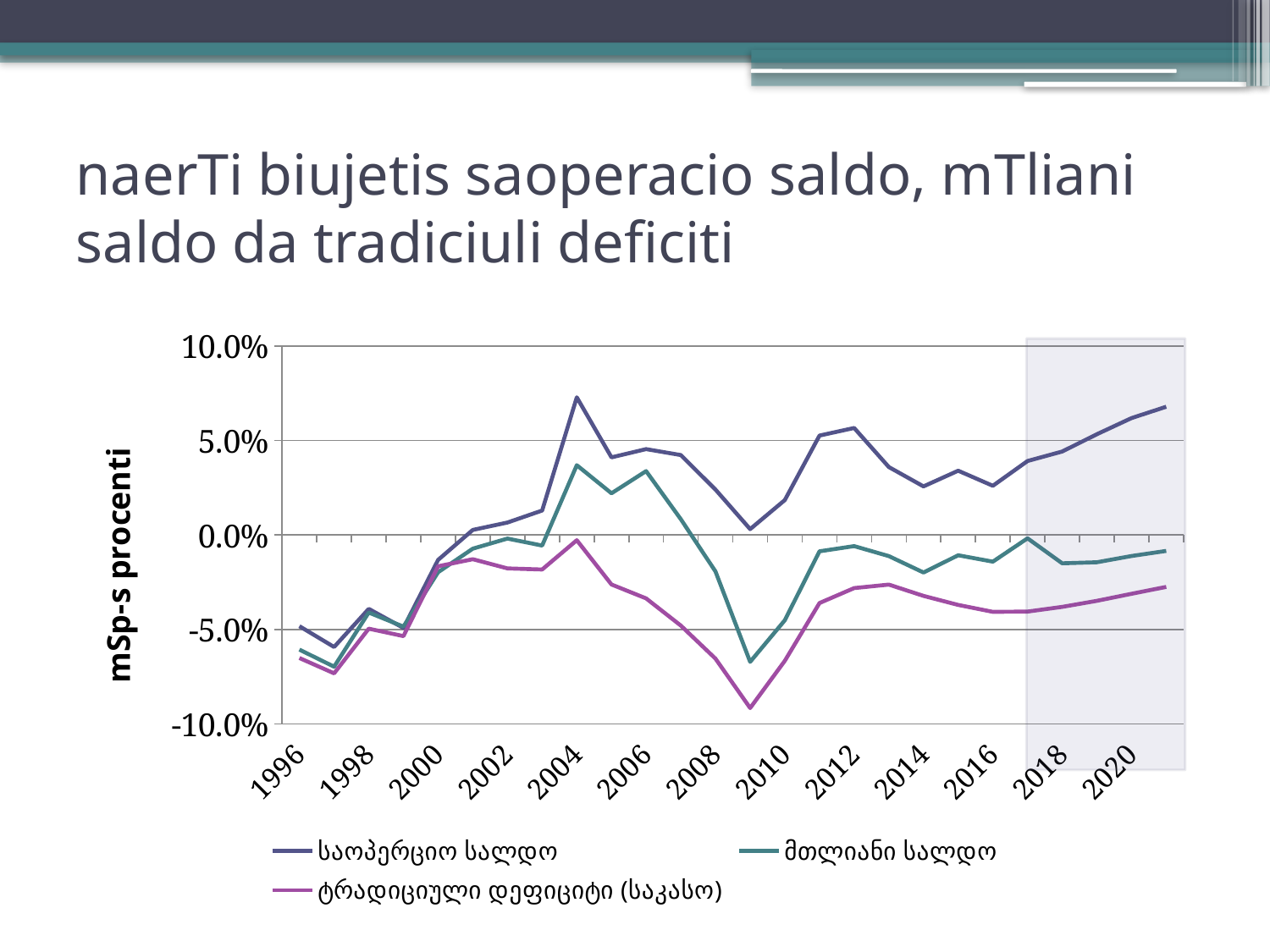
How many series does the chart's legend list? 3 In 2004, which series has the higher value: საოპერაციო სალდო or მთლიანი სალდო? საოპერაციო სალდო Is the value of საოპერაციო სალდო in 2004 greater or less than 5.0%? greater What is the title of the slide containing the chart? naerTi biujetis saoperacio saldo, mTliani saldo da tradiciuli deficiti What kind of chart is shown on the slide? line chart What is the label on the vertical axis of the chart? mSp-s procenti Is the value of საოპერაციო სალდო in 2020 greater or less than 5.0%? greater Is the value of ტრადიციული დეფიციტი (საკასო) in 2009 greater or less than -5.0%? less In which year does საოპერაციო სალდო reach its highest value? 2004 Does საოპერაციო სალდო rise or fall between 2016 and 2020? rise In which year does ტრადიციული დეფიციტი (საკასო) reach its lowest value? 2009